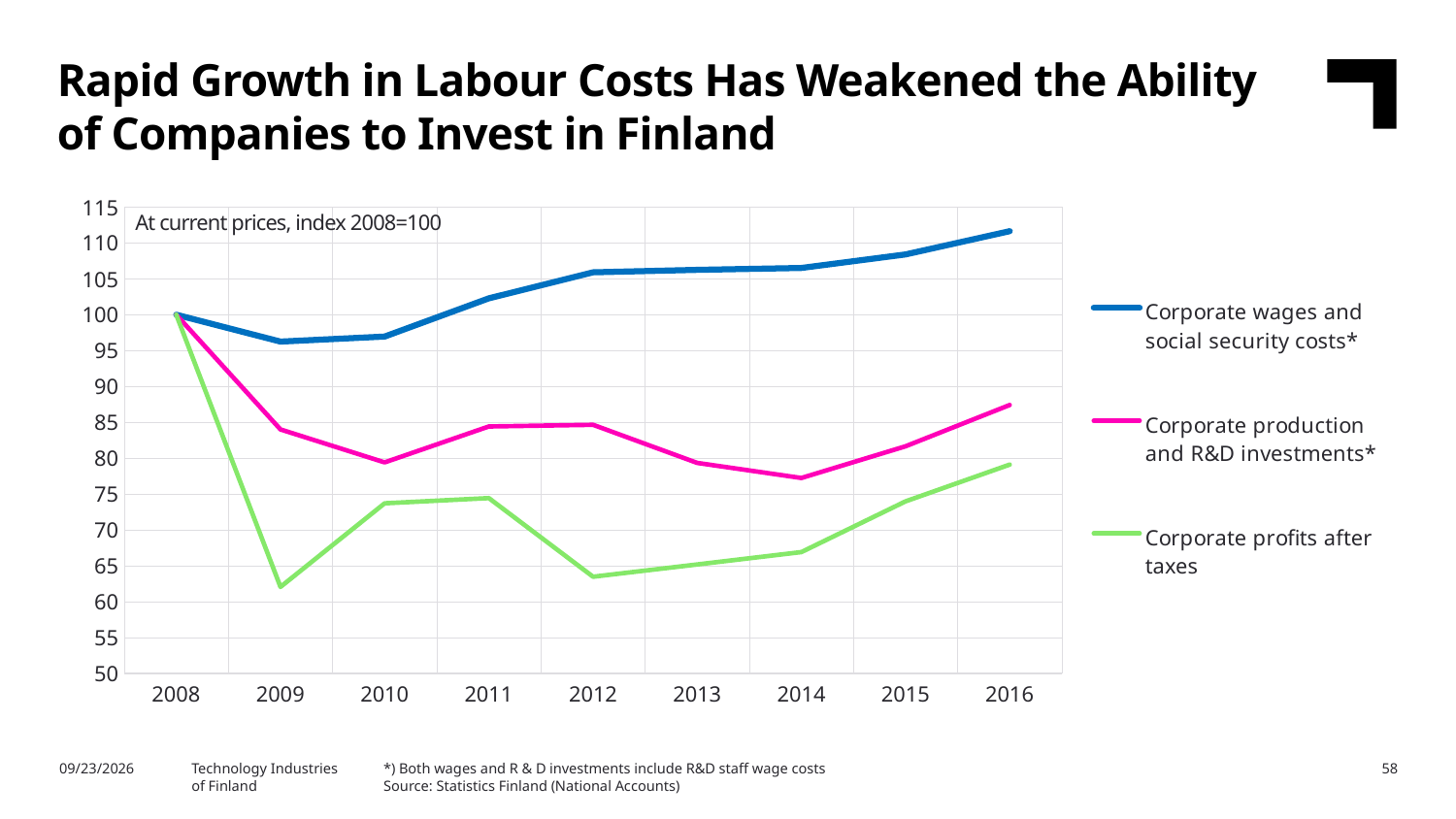
What base year and value does the index use, according to the note in the chart? index 2008=100 Does the value for Corporate wages and social security costs rise or fall between 2010 and 2016? rise Is the value for Corporate profits after taxes in 2009 greater or less than 65? less Which series has the higher value in 2014: Corporate production and R&D investments or Corporate profits after taxes? Corporate production and R&D investments In which year is the value for Corporate profits after taxes lowest? 2009 How many years are shown on the x axis? 9 What is the index value of all three series in 2008? 100 In which year is the value for Corporate wages and social security costs highest? 2016 How many series does the legend list? 3 What kind of chart is shown on the slide? line chart Is the value for Corporate production and R&D investments in 2016 greater or less than 85? greater Is the value for Corporate wages and social security costs in 2016 greater or less than 110? greater